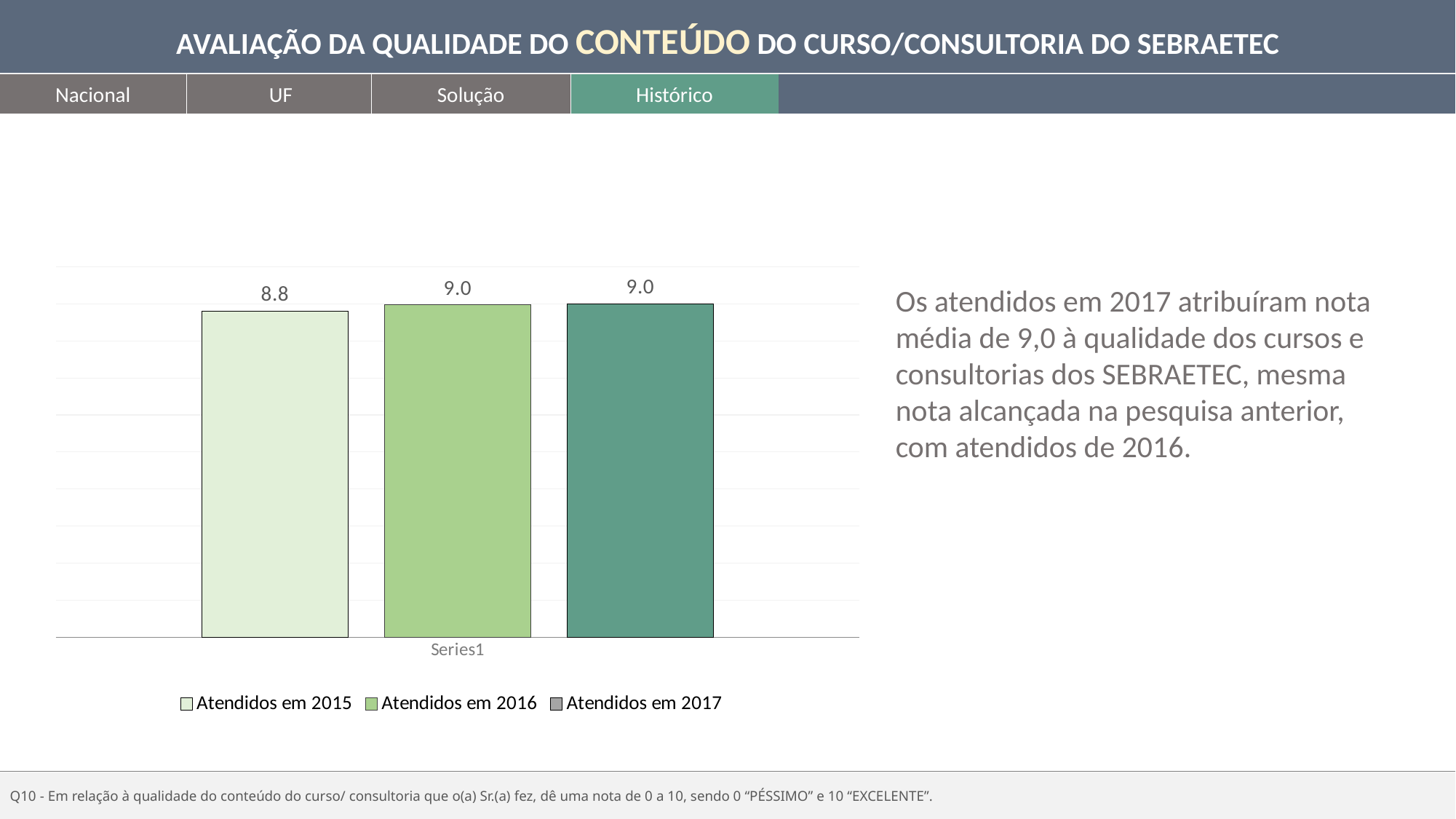
How many bars are plotted in the chart? 3 Do the values rise or fall from Atendidos em 2015 to Atendidos em 2016? rise What is the category label shown on the x axis? Series1 Which legend entry is shown with the darkest green colour? Atendidos em 2017 How many series does the legend list? 3 What kind of chart is shown on the slide? bar chart What is the value for Atendidos em 2015? 8.8 What is the value for Atendidos em 2017? 9.0 What is the difference between the values for Atendidos em 2016 and Atendidos em 2015? 0.2 What is the value for Atendidos em 2016? 9.0 Which is larger, the value for Atendidos em 2015 or Atendidos em 2017? Atendidos em 2017 Which series has the lowest value? Atendidos em 2015